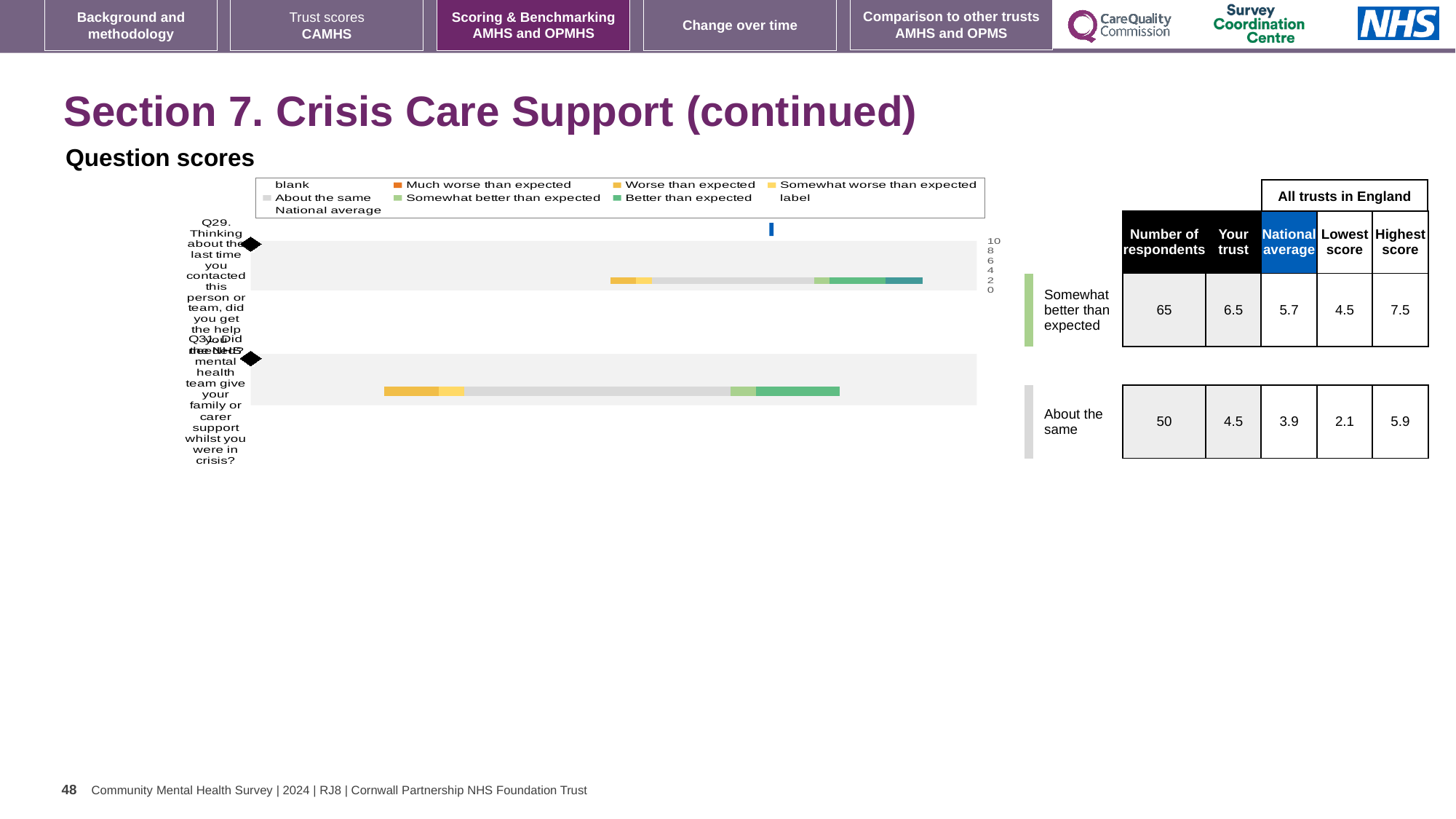
What kind of chart is used to show the question scores on this slide? bar chart Which question has the higher 'Your trust' score, Q29 or Q31? Q29 How many respondents answered Q29? 65 What is the 'Your trust' score for Q29 (Thinking about the last time you contacted this person or team, did you get the help you needed)? 6.5 Which benchmark category is shown for Q31? About the same How many questions (categories) are plotted in the question scores chart? 2 What is the lowest score among all trusts in England for Q29? 4.5 What is the national average score for Q31 (Did the NHS mental health team give your family or carer support whilst you were in crisis)? 3.9 Which benchmark category is shown for Q29? Somewhat better than expected What is the difference between the 'Your trust' score and the national average for Q29? 0.8 What is the difference between the highest and lowest scores for Q31? 3.8 What is the highest score among all trusts in England for Q31? 5.9